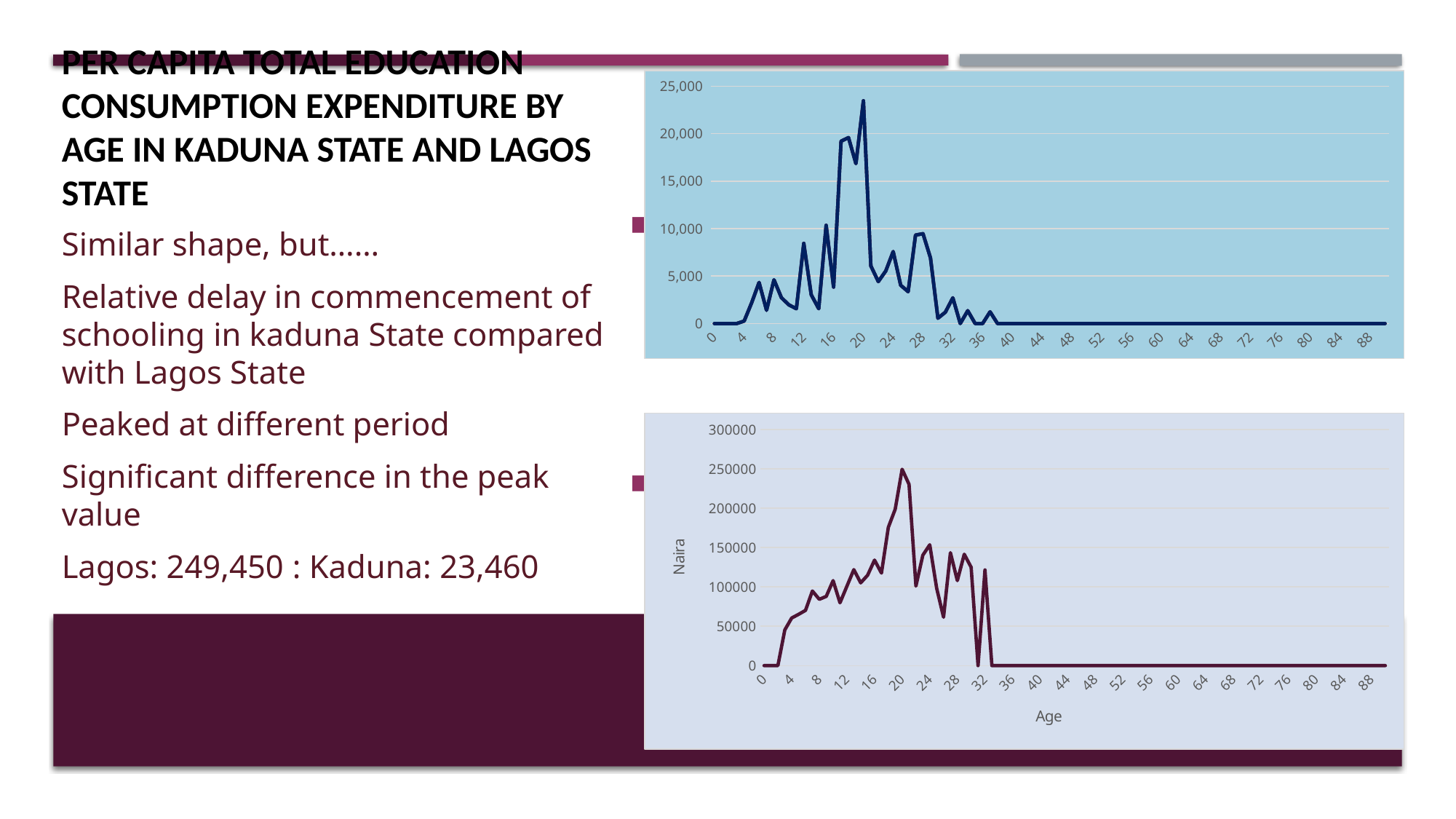
In the bottom chart, is the value at age 4 greater or less than 100000? less In the top chart, is the value at age 60 greater or less than 5,000? less In the bottom chart, does the line generally rise or fall between age 4 and age 20? rise In the bottom chart, what is the label on the vertical axis? Naira In the bottom chart, what is the label on the horizontal axis? Age What kind of chart is the bottom chart on the slide? Line chart In the top chart, is the highest value of the line greater or less than 20,000? greater In the top chart, how does the line behave from age 40 to age 88? It stays flat at 0 What kind of chart is the top chart on the slide? Line chart